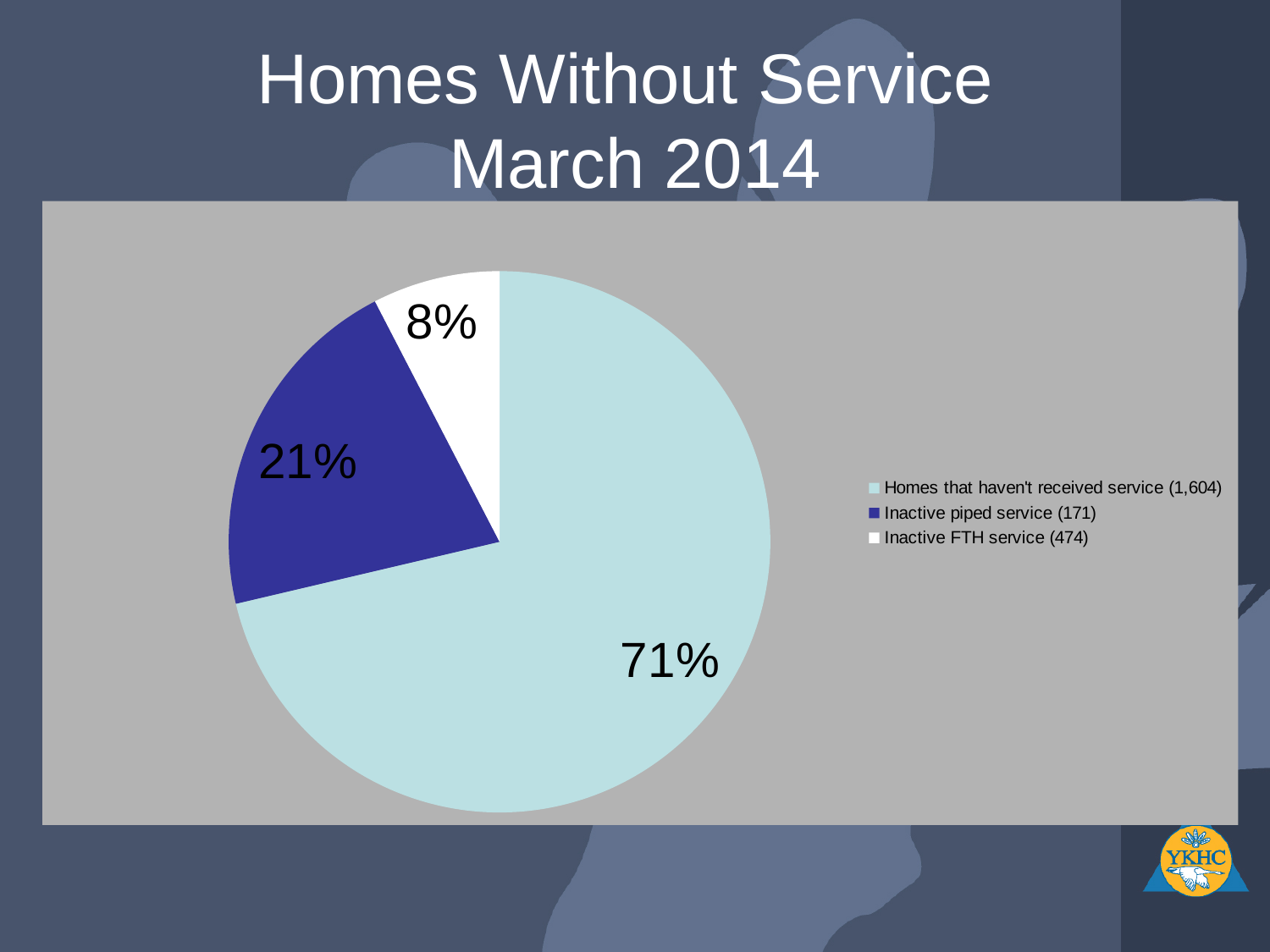
What number is given in the legend for inactive FTH service? 474 What number is given in the legend for inactive piped service? 171 What percentage is shown on the white slice of the pie? 8% What is the difference in percentage points between the 71% slice and the 21% slice? 50 percentage points How many entries does the legend list? 3 Which category has the largest slice of the pie? Homes that haven't received service What share of the pie is labelled for homes that haven't received service? 71% What number is given in the legend for homes that haven't received service? 1,604 How many slices does the pie chart have? 3 What is the title of the chart on the slide? Homes Without Service March 2014 What percentage is shown on the dark blue slice of the pie? 21% What kind of chart is shown on the slide? pie chart